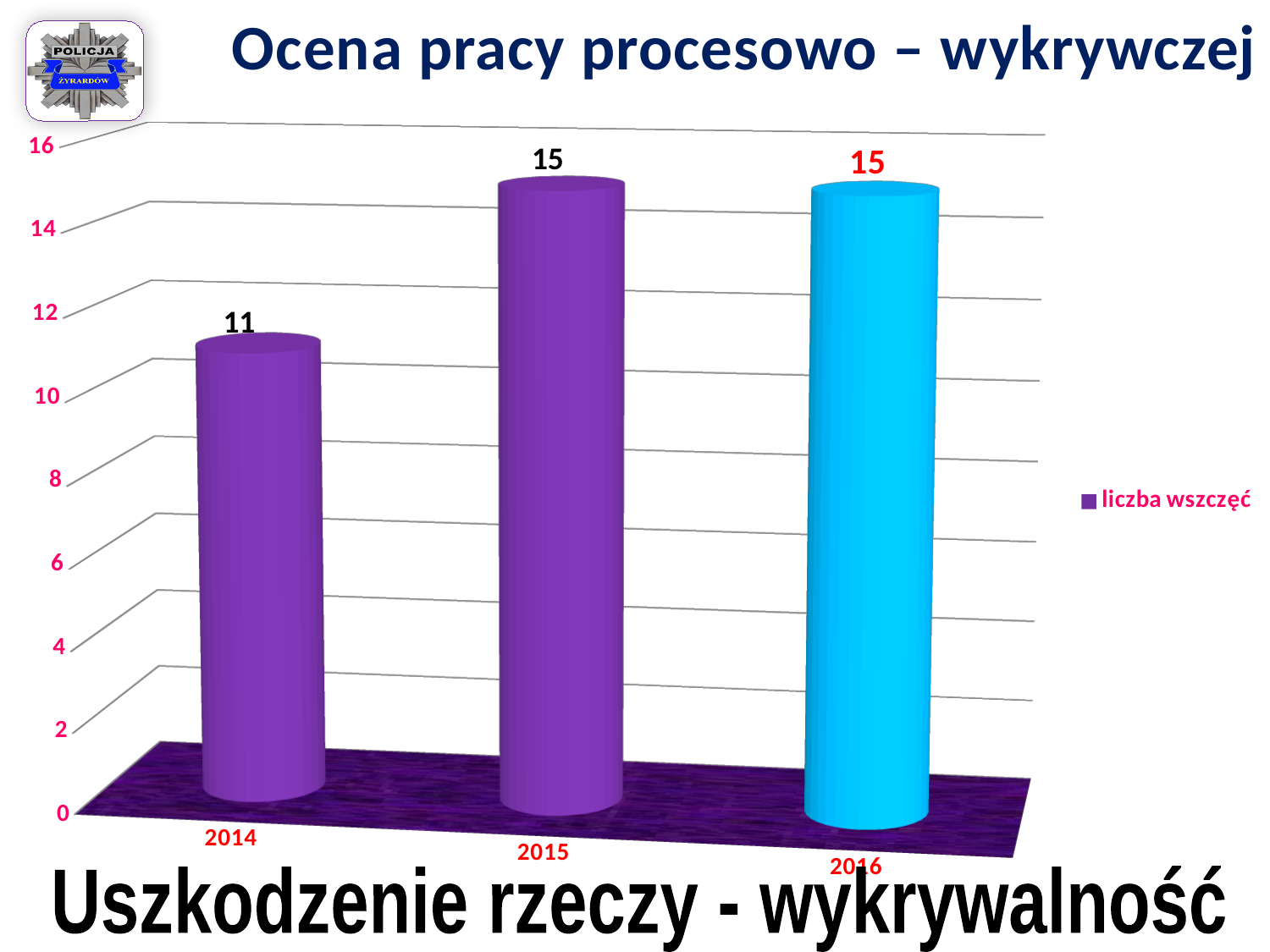
Is the value for 2014 greater or less than 10? greater Which is larger, the value for 2014 or the value for 2016? 2016 What is the value for 2016? 15 What is the value for 2015? 15 Which year has the lowest value? 2014 How many series does the legend list? 1 How many years are shown on the x axis? 3 What is the difference between the values for 2015 and 2014? 4 What is the value for 2014? 11 What is the legend entry of the chart? liczba wszczęć What kind of chart is shown on the slide? bar chart Do the values rise or fall from 2014 to 2015? rise